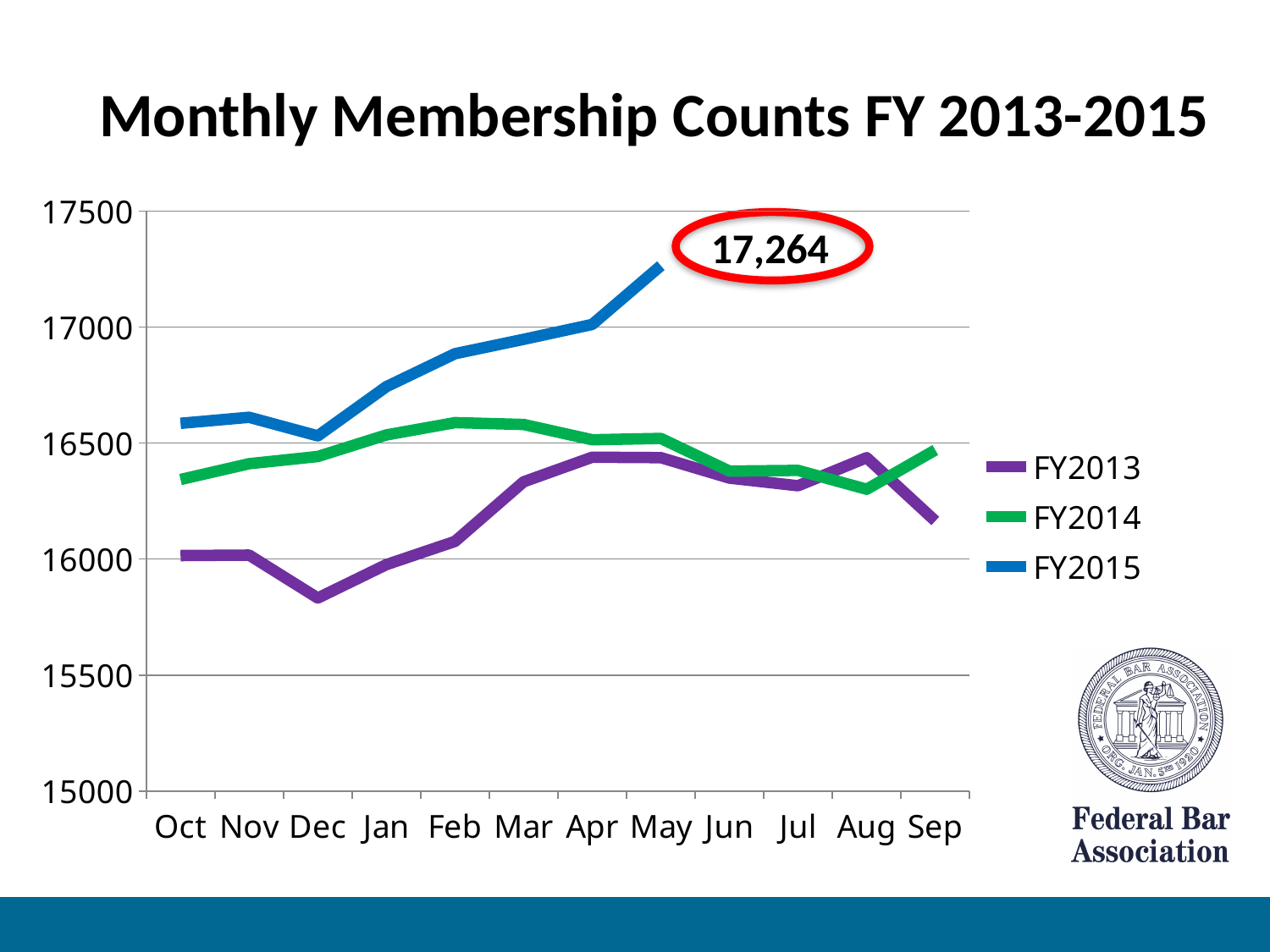
How many series does the legend list? 3 Does the FY2015 line rise or fall from Dec to May? rise In which month does the FY2013 line reach its lowest value? Dec What is the title of the chart? Monthly Membership Counts FY 2013-2015 Is the FY2015 value for Oct greater or less than 16500? greater Which series has the highest value in May? FY2015 What kind of chart is shown on the slide? line chart Is the FY2013 value for Dec greater or less than 16000? less Which is larger in Jan, the FY2013 value or the FY2014 value? FY2014 Is the FY2015 value for Feb greater or less than 17000? less What is the FY2015 membership count for May, as labeled on the chart? 17,264 How many months are shown along the x axis? 12